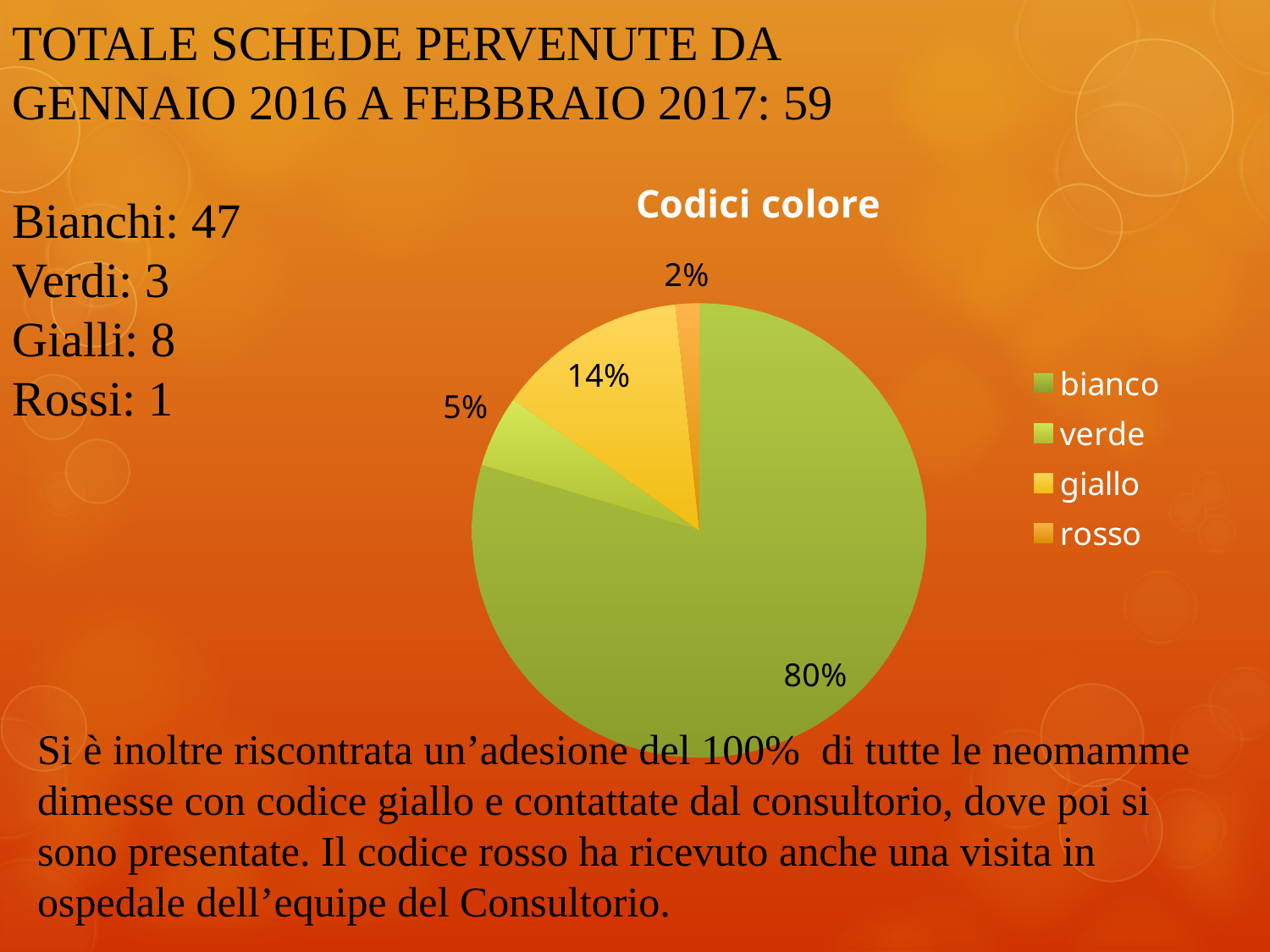
What share of the pie does the verde slice represent? 5% What share of the pie does the bianco slice represent? 80% What is the difference in percentage points between the verde and rosso slices? 3 Which slice is larger, giallo or verde? giallo What share of the pie does the giallo slice represent? 14% Which category has the largest slice of the pie? bianco What is the title of the chart? Codici colore What kind of chart is shown on the slide? pie chart What is the difference in percentage points between the bianco and giallo slices? 66 How many categories does the legend list? 4 Which category has the smallest slice of the pie? rosso